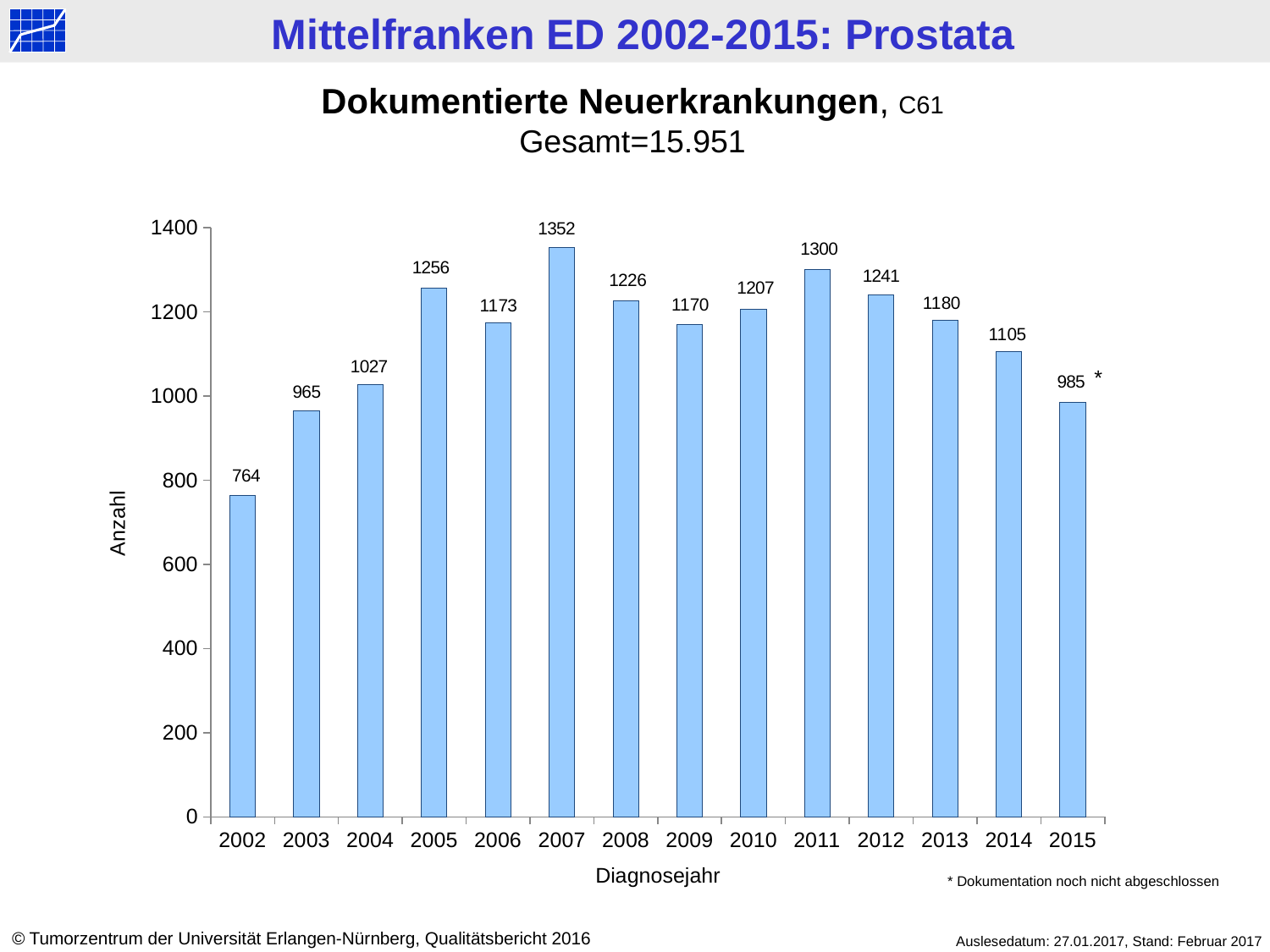
What is the value for 2002? 764 What is the difference between the values for 2007 and 2002? 588 What is the value for 2007? 1352 What kind of chart is shown on the slide? bar chart Which year has the highest value? 2007 What is the value for 2015? 985 What is the difference between the values for 2011 and 2012? 59 Which is larger, the value for 2005 or the value for 2008? 2005 Is the value for 2004 greater or less than 1000? greater How many years are shown on the x axis? 14 What is the label of the y axis? Anzahl Which year has the lowest value? 2002